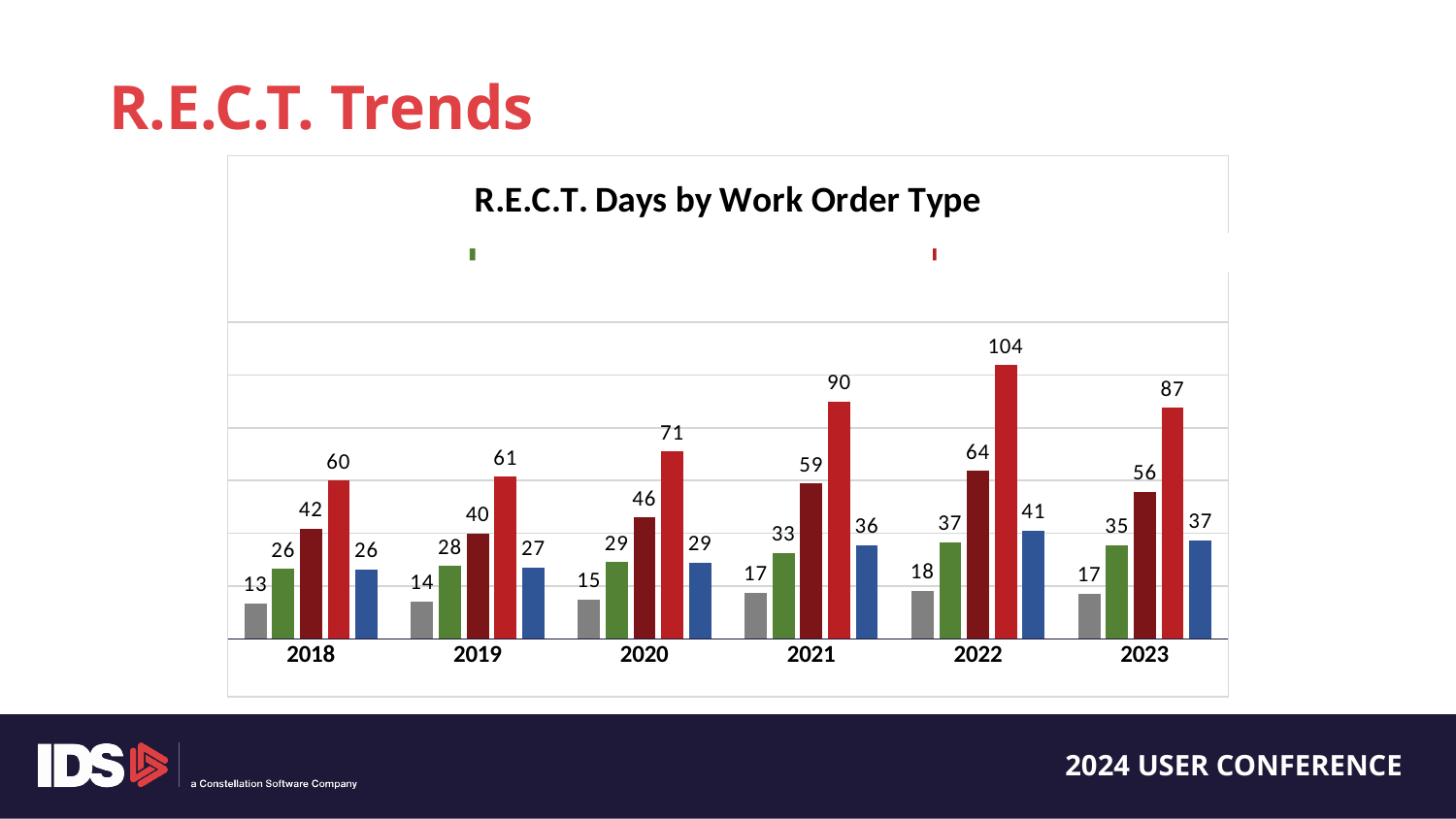
What is the value of the blue bar for 2021? 36 How many years are shown on the x axis of the chart? 6 What is the difference between the bright red bar values for 2022 and 2023? 17 What type of chart is shown on the slide? bar chart Which is larger: the green bar for 2022 or the green bar for 2023? 2022 In which year is the gray bar lowest? 2018 In which year does the bright red bar reach its highest value? 2022 What is the value of the tallest (bright red) bar for 2022? 104 What is the value of the dark red bar for 2020? 46 Does the bright red bar rise or fall from 2018 to 2022? rise What is the title of the chart? R.E.C.T. Days by Work Order Type What is the value of the gray bar for 2018? 13